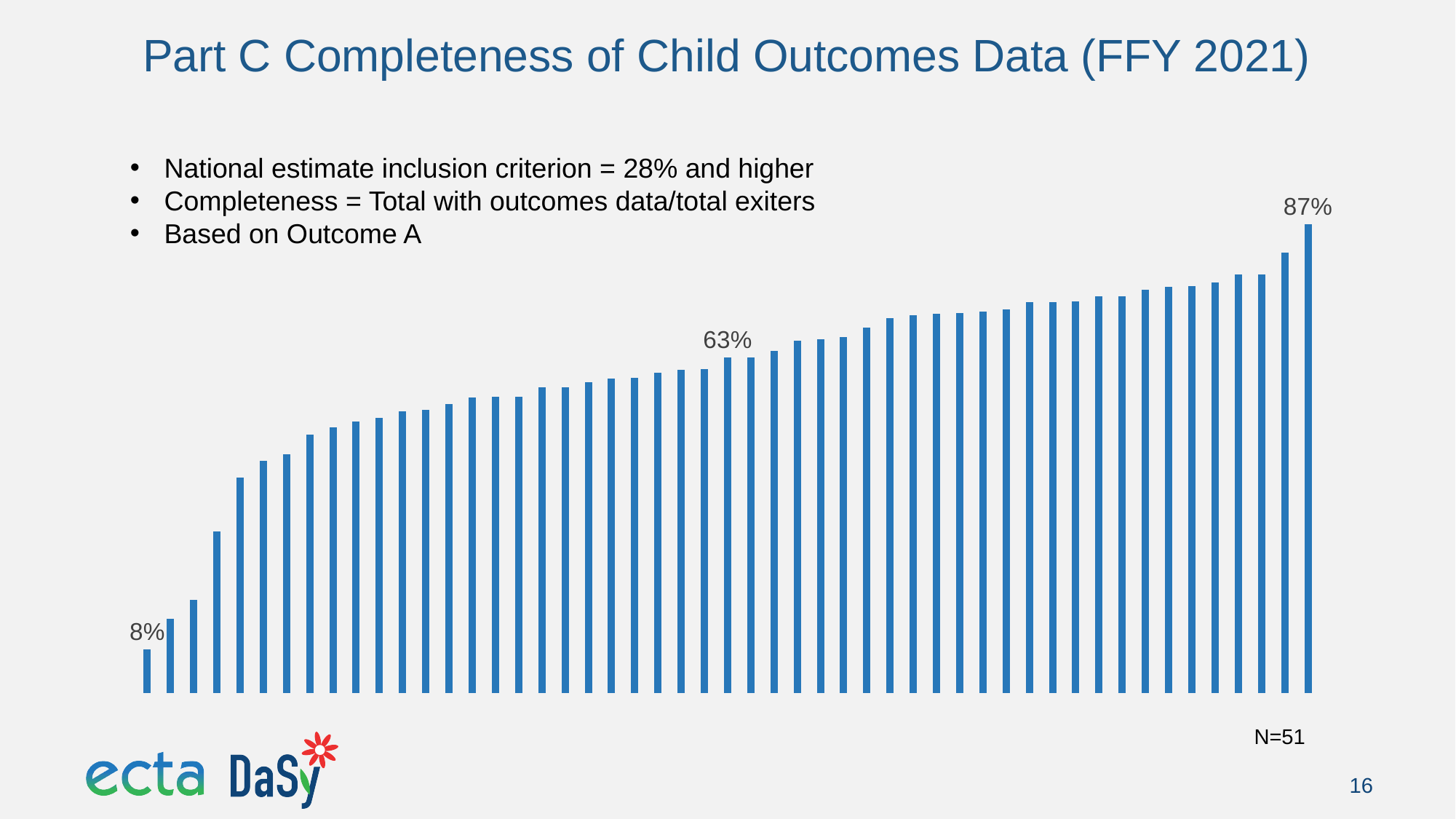
What is the difference between the middle labeled value (63%) and the lowest labeled value (8%)? 55 percentage points What colour are the bars in the chart? Blue What value is labeled on the bar in the middle of the chart? 63% How many bars (N) are plotted on the chart? 51 What type of chart is shown on the slide? Bar chart What is the difference between the highest labeled value (87%) and the middle labeled value (63%)? 24 percentage points What is the highest value shown on the chart? 87% Do the bar values rise or fall from left to right across the chart? Rise What is the title of the slide containing the chart? Part C Completeness of Child Outcomes Data (FFY 2021) What is the lowest value shown on the chart? 8% What is the difference between the highest labeled value (87%) and the lowest labeled value (8%)? 79 percentage points Which is larger, the value of the leftmost bar or the value of the rightmost bar? The rightmost bar (87%)